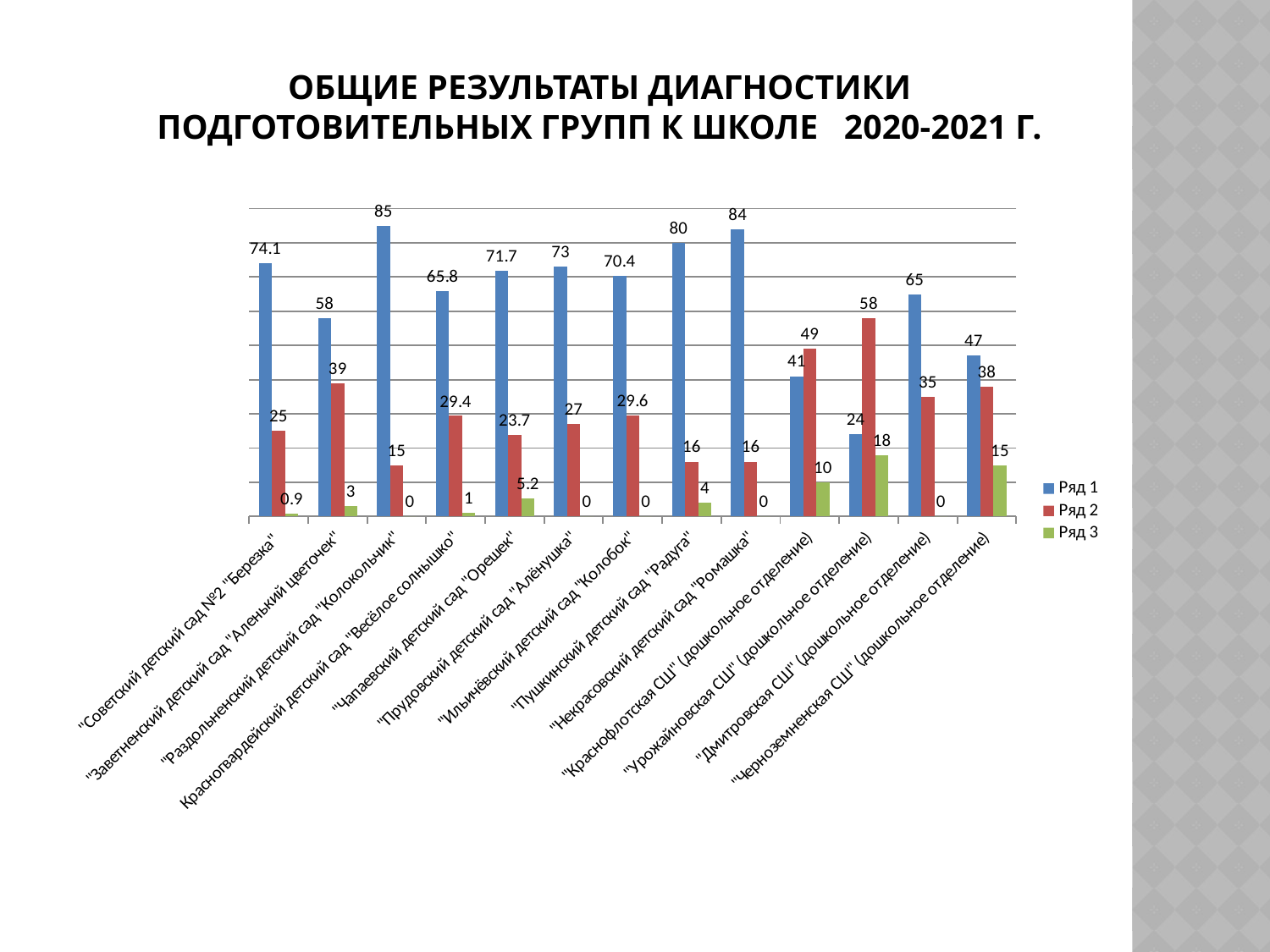
Which category has the lowest value for Ряд 1? "Урожайновская СШ" (дошкольное отделение) How many series does the legend list? 3 What is the value of Ряд 2 for "Урожайновская СШ" (дошкольное отделение)? 58 For "Краснофлотская СШ" (дошкольное отделение), which is larger: Ряд 1 or Ряд 2? Ряд 2 How many categories (institutions) are shown on the x axis? 13 What is the value of Ряд 1 for "Раздольненский детский сад "Колокольчик""? 85 Which category has the highest value for Ряд 1? "Раздольненский детский сад "Колокольчик"" What is the difference between the Ряд 1 values for "Пушкинский детский сад "Радуга"" and "Некрасовский детский сад "Ромашка""? 4 What type of chart is shown on the slide? Bar chart What is the value of Ряд 3 for "Чапаевский детский сад "Орешек""? 5.2 Which category has the highest value for Ряд 3? "Урожайновская СШ" (дошкольное отделение) What is the title of the chart on the slide? ОБЩИЕ РЕЗУЛЬТАТЫ ДИАГНОСТИКИ ПОДГОТОВИТЕЛЬНЫХ ГРУПП К ШКОЛЕ 2020-2021 Г.